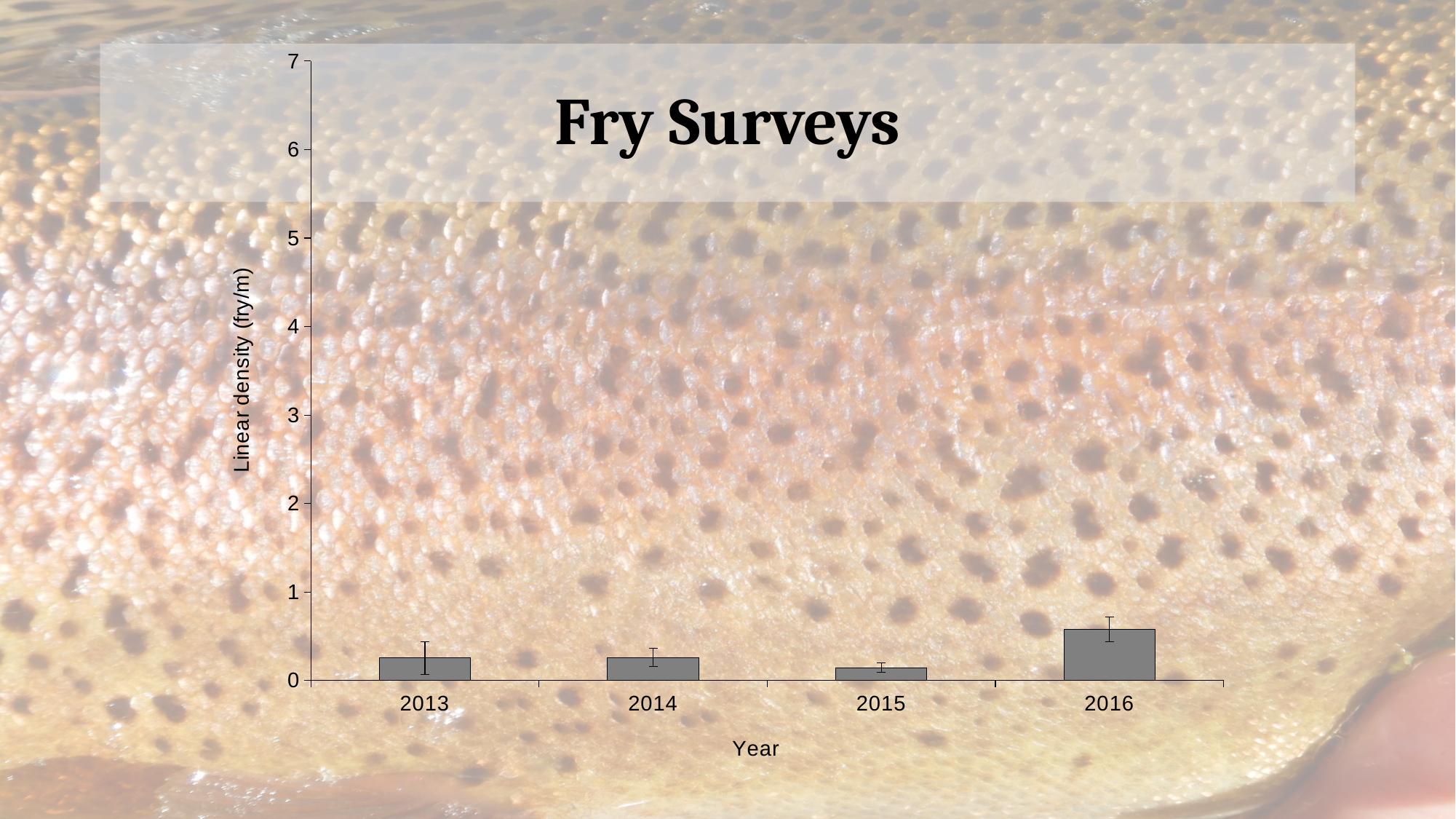
What kind of chart is shown on the slide? bar chart Is the value for 2016 greater or less than 1? less Does the linear density rise or fall from 2015 to 2016? rise Which year has the lowest linear density? 2015 How many years are shown on the x axis of the chart? 4 Which year has the highest linear density? 2016 Which is larger, the value for 2016 or the value for 2015? 2016 What is the title of the chart? Fry Surveys Which is larger, the value for 2013 or the value for 2015? 2013 What is the label of the y axis? Linear density (fry/m) Is the value for 2013 greater or less than 1? less